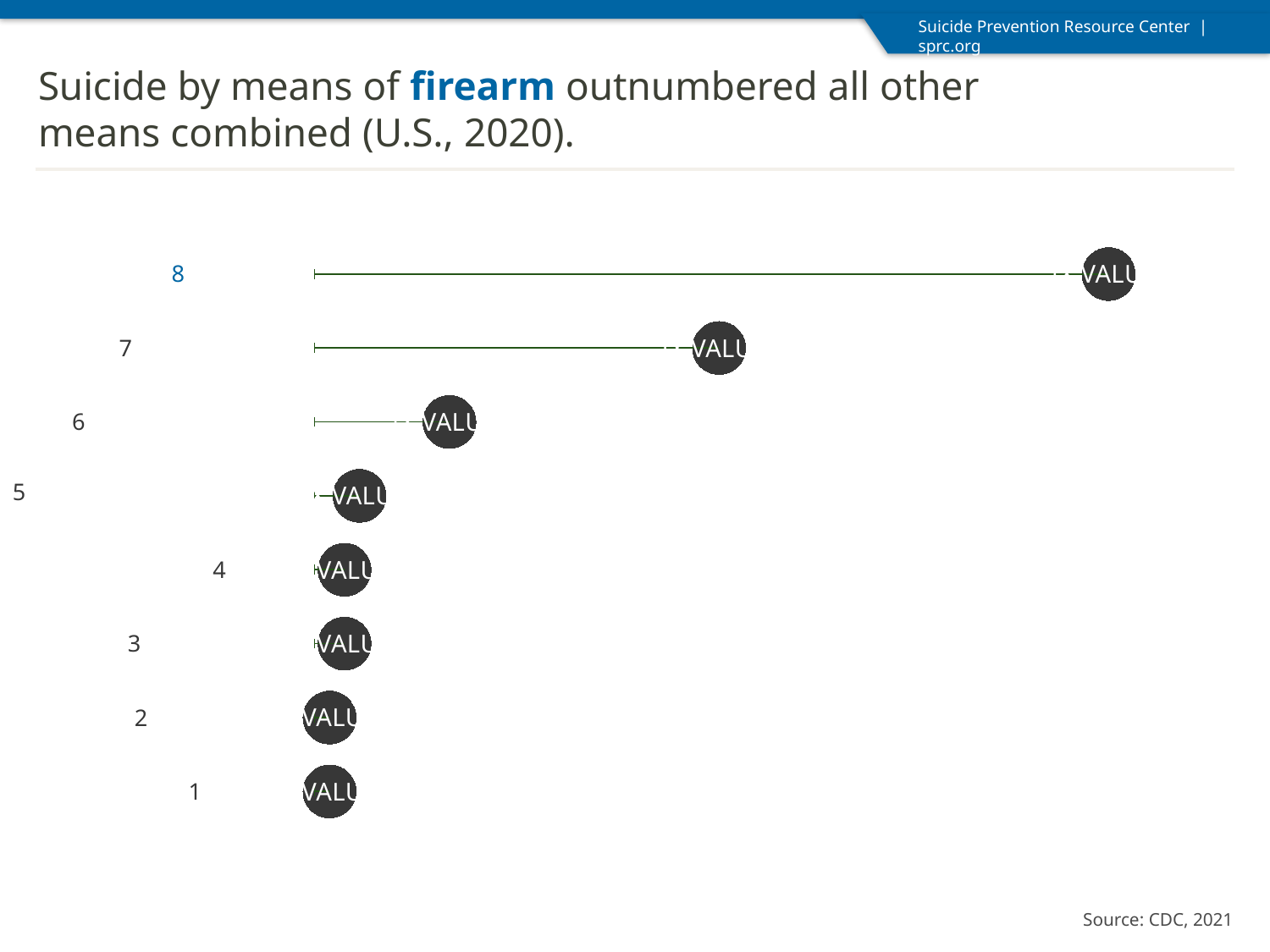
How many categories are plotted on the chart? 8 Do the values rise or fall going from category 8 at the top down to category 1 at the bottom? fall Which category has the highest value on the chart? 8 Which has the larger value, category 7 or category 6? 7 Which has the larger value, category 8 or category 7? 8 Which has the larger value, category 6 or category 5? 6 Which category label on the chart is shown in blue? 8 What is the title of the slide containing the chart? Suicide by means of firearm outnumbered all other means combined (U.S., 2020).